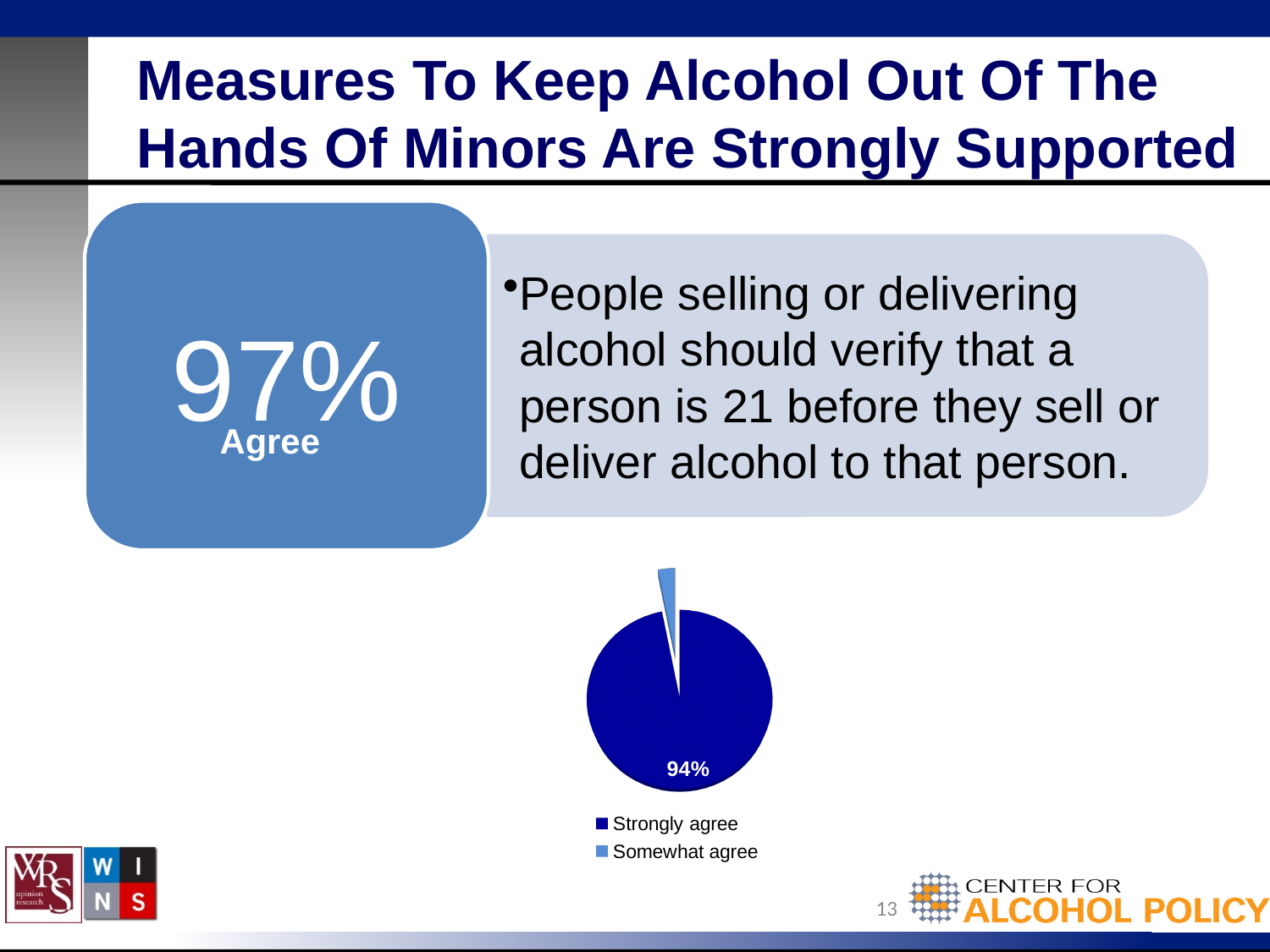
Which slice is larger in the pie chart, 'Strongly agree' or 'Somewhat agree'? Strongly agree What kind of chart is shown on the slide? pie chart Which legend entry in the pie chart is shown in dark blue? Strongly agree Which legend entry in the pie chart is shown in light blue? Somewhat agree What share of the pie does the 'Strongly agree' slice represent? 94% How many slices does the pie chart have? 2 What percentage of the pie chart is labelled for the 'Strongly agree' slice? 94% How many entries does the pie chart's legend list? 2 Is the 'Strongly agree' slice of the pie chart greater or less than 50%? greater Which slice of the pie chart is the smallest? Somewhat agree Which slice of the pie chart is the largest? Strongly agree